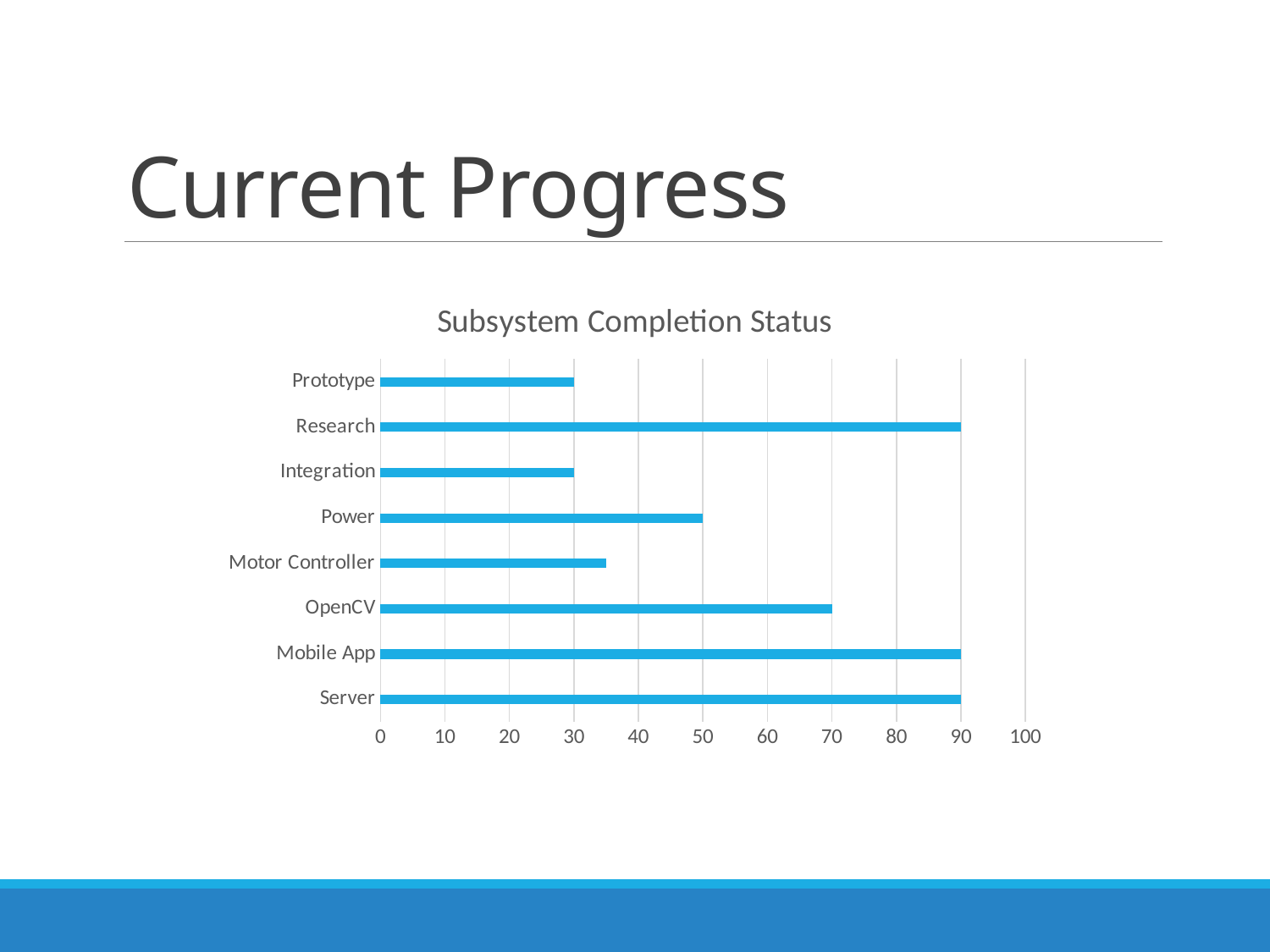
What is the value for Prototype in the Subsystem Completion Status chart? 30 What is the value for OpenCV in the Subsystem Completion Status chart? 70 Is the value for Motor Controller greater or less than 30? greater What is the value for Integration in the Subsystem Completion Status chart? 30 How many subsystems are shown in the chart? 8 Which has a larger value, OpenCV or Power? OpenCV What kind of chart is shown on the slide? bar chart What is the value for Research in the Subsystem Completion Status chart? 90 What is the title of the chart? Subsystem Completion Status What is the difference between the values for Research and Prototype? 60 Is the value for Motor Controller greater or less than 40? less What is the value for Power in the Subsystem Completion Status chart? 50